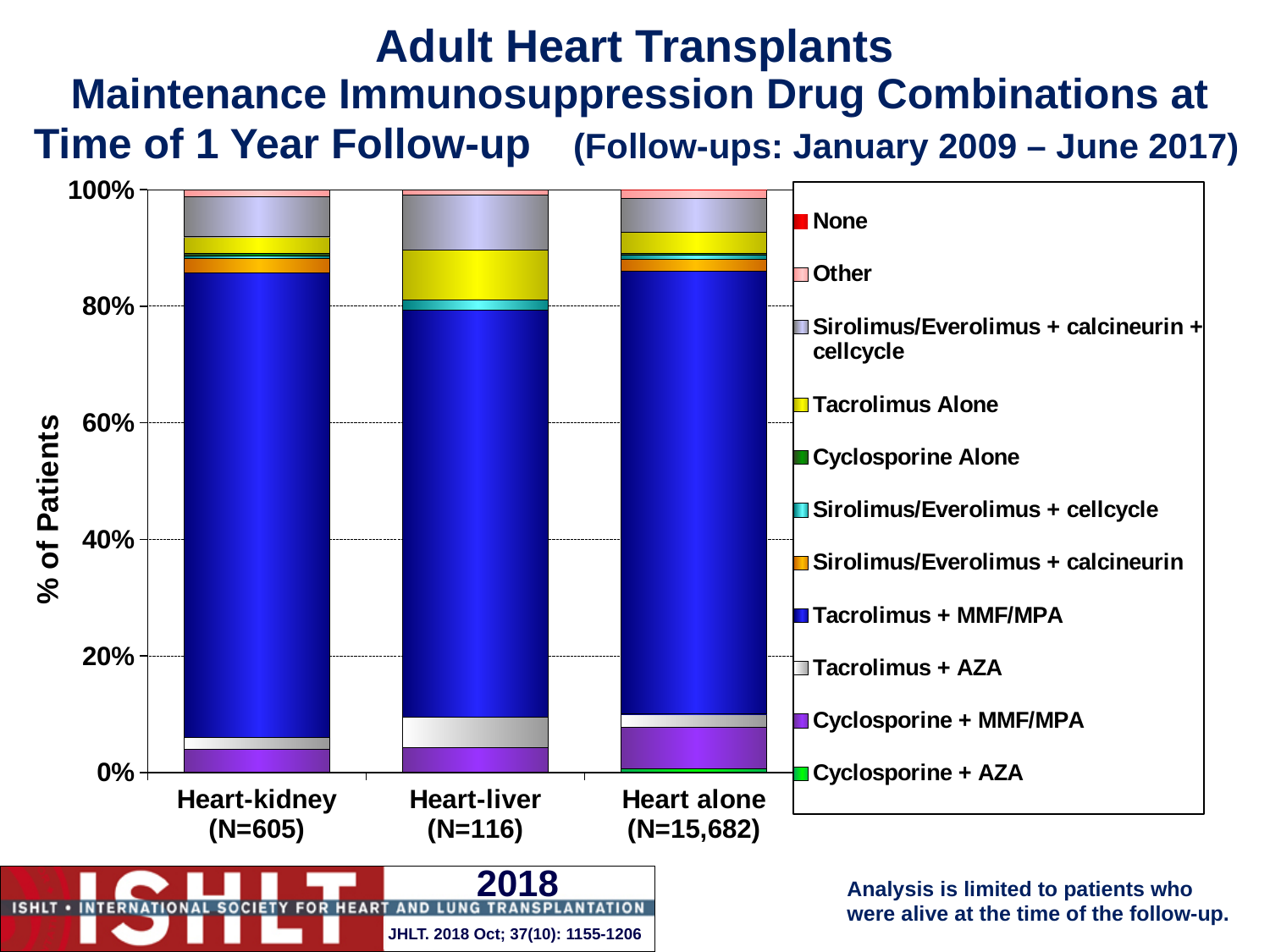
What is the label of the y axis? % of Patients Is the top of the Tacrolimus + MMF/MPA segment for Heart-kidney greater or less than 80%? greater What kind of chart is shown on the slide? Stacked bar chart Is the Tacrolimus Alone segment larger for Heart-liver or for Heart-kidney? Heart-liver Which category has the smallest Tacrolimus + MMF/MPA segment? Heart-liver What is the sample size (N) for the Heart-liver category? 116 Which category has the largest Tacrolimus Alone segment? Heart-liver Which legend entry is shown in red? None How many drug combination series does the legend list? 11 Which category has the largest Cyclosporine + MMF/MPA segment? Heart alone What is the sample size (N) for the Heart alone category? 15,682 How many transplant categories are shown on the x axis? 3